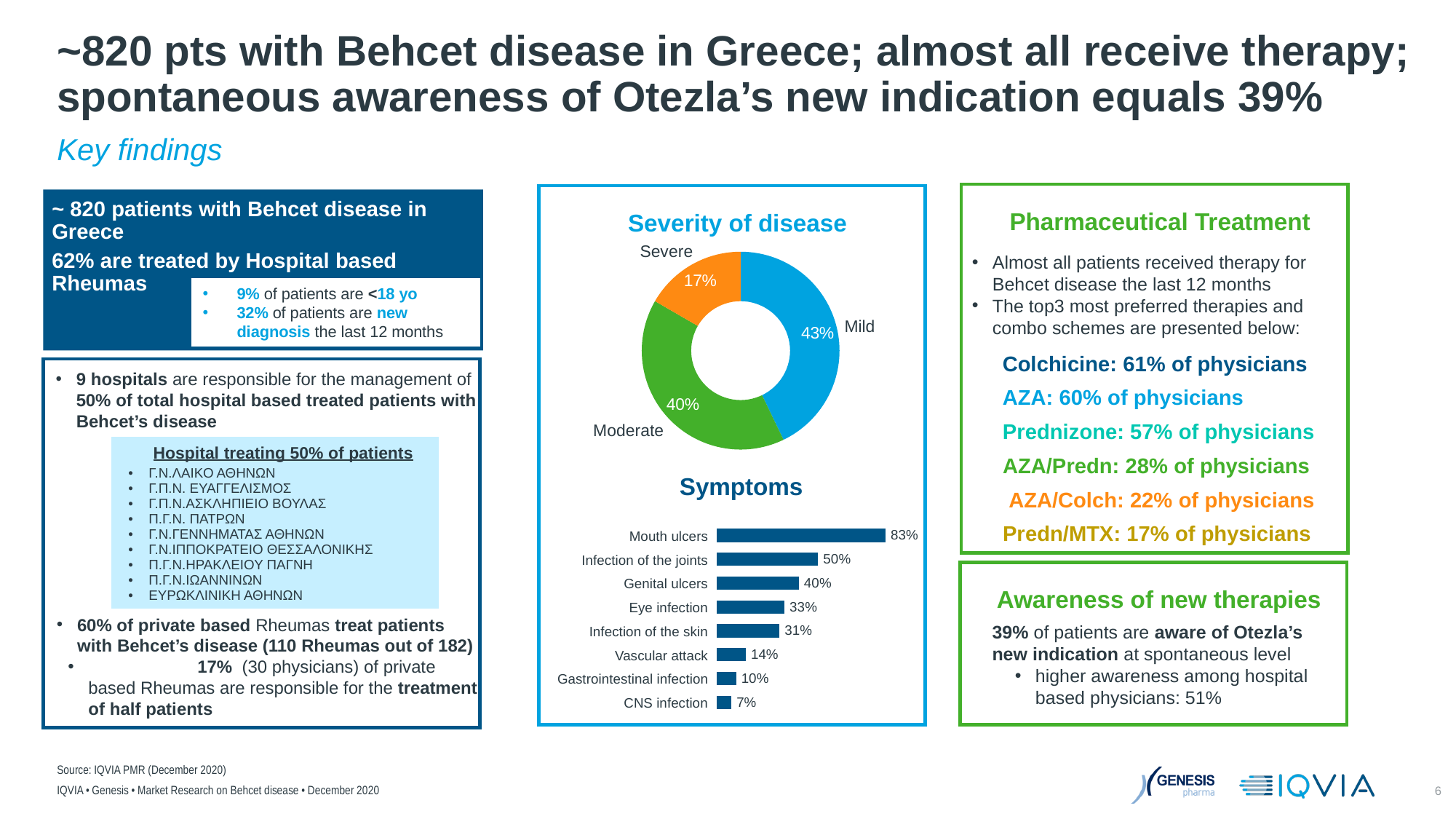
In the Severity of disease chart, which severity category has the smallest share? Severe In the Symptoms chart, what is the value for Infection of the joints? 50% In the Severity of disease chart, what share of patients have mild disease? 43% In the Symptoms chart, which symptom has the highest value? Mouth ulcers How many symptoms are listed in the Symptoms chart? 8 What kind of chart is the Severity of disease chart? Doughnut (pie) chart In the Symptoms chart, which symptom has the lowest value? CNS infection In the Symptoms chart, what is the value for Vascular attack? 14% In the Symptoms chart, what is the difference between Mouth ulcers and Genital ulcers? 43% In the Severity of disease chart, which severity category has the largest share? Mild In the Severity of disease chart, what is the difference between the Moderate and Severe shares? 23% In the Severity of disease chart, what share of patients have severe disease? 17%